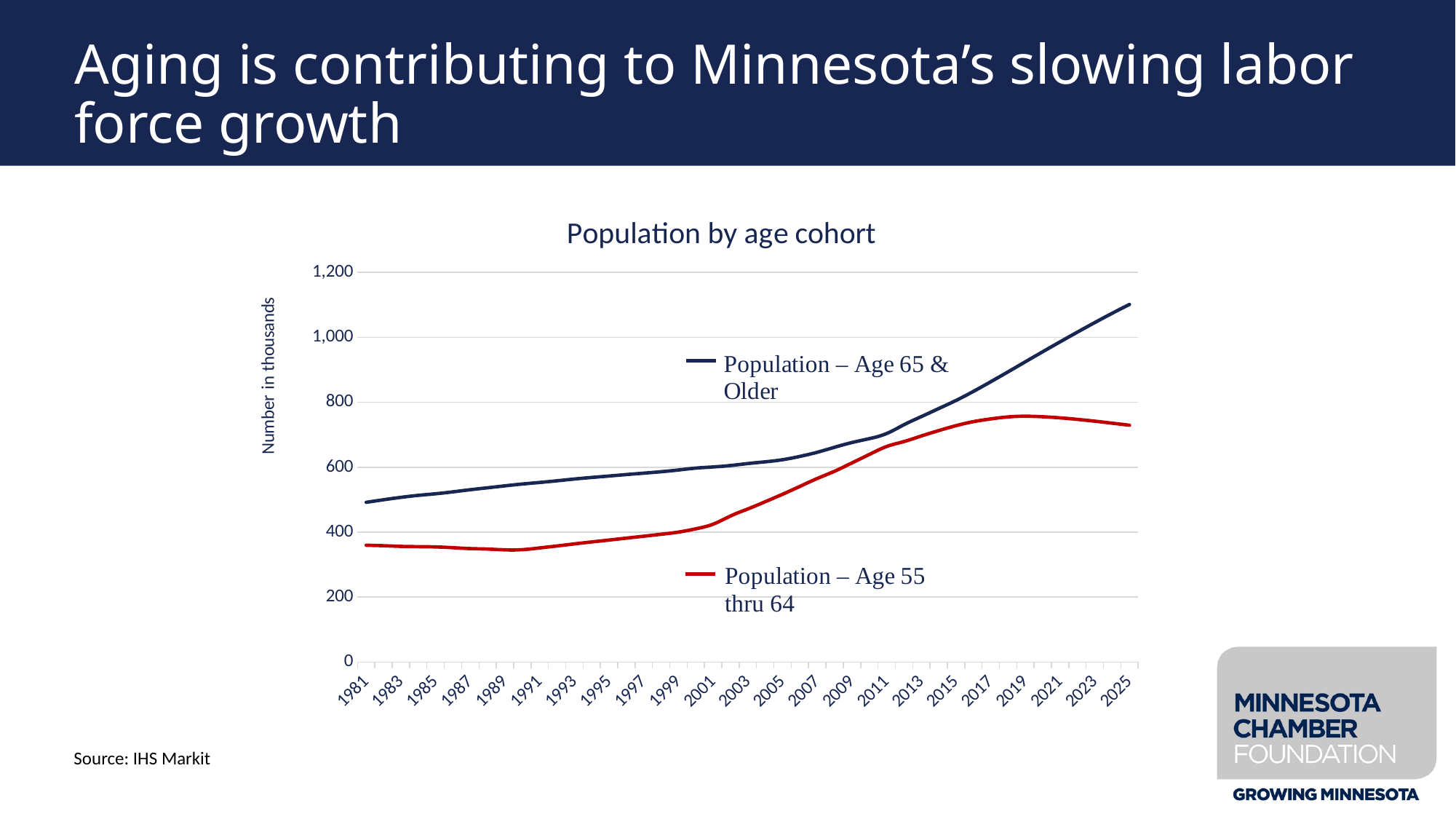
How many year labels are shown along the x axis of the chart? 23 Does the Population – Age 65 & Older line rise or fall from 1981 to 2025? Rises What kind of chart is shown on the slide? Line chart What is the title of the chart? Population by age cohort Is the value for Population – Age 55 thru 64 in 2025 greater or less than 800? less Does the Population – Age 55 thru 64 line rise or fall between 2019 and 2025? Falls Is the value for Population – Age 55 thru 64 in 1981 greater or less than 400? less Is the value for Population – Age 65 & Older in 1981 greater or less than 600? less In 2025, which series has the higher value: Population – Age 65 & Older or Population – Age 55 thru 64? Population – Age 65 & Older What is the label on the vertical axis of the chart? Number in thousands How many series does the chart's legend list? 2